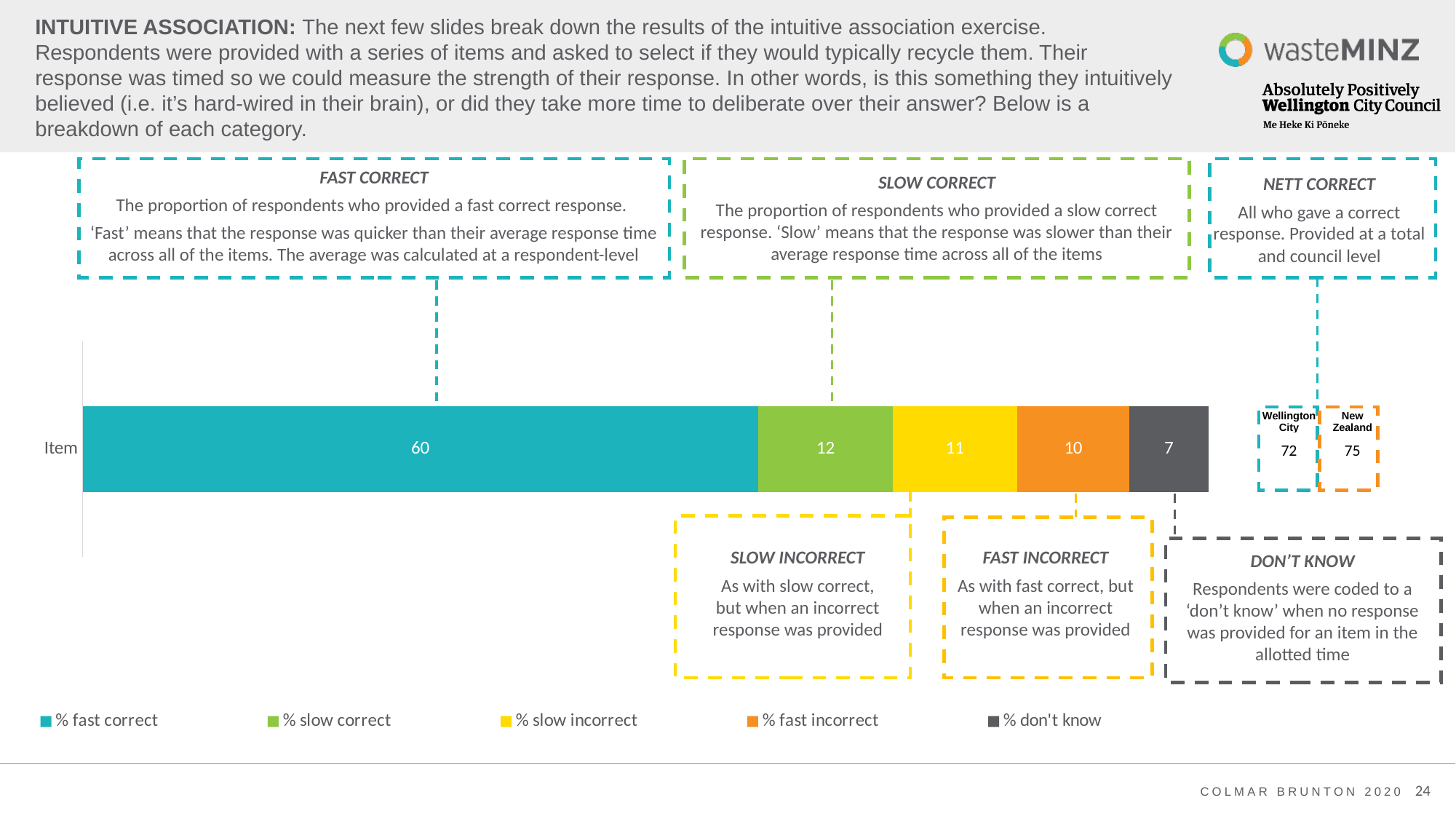
What is the value for % slow correct for Item? 12 What kind of chart is shown? Stacked bar chart How many series does the legend list? 5 What is the value for % slow incorrect for Item? 11 What is the difference between % fast correct and % slow correct for Item? 48 What is the value for % fast correct for Item? 60 Which series has the lowest value for Item? % don't know What is the value for % don't know for Item? 7 What is the total of the stacked bar for Item? 100 Which is larger for Item, % slow incorrect or % fast incorrect? % slow incorrect Which series has the highest value for Item? % fast correct What is the value for % fast incorrect for Item? 10